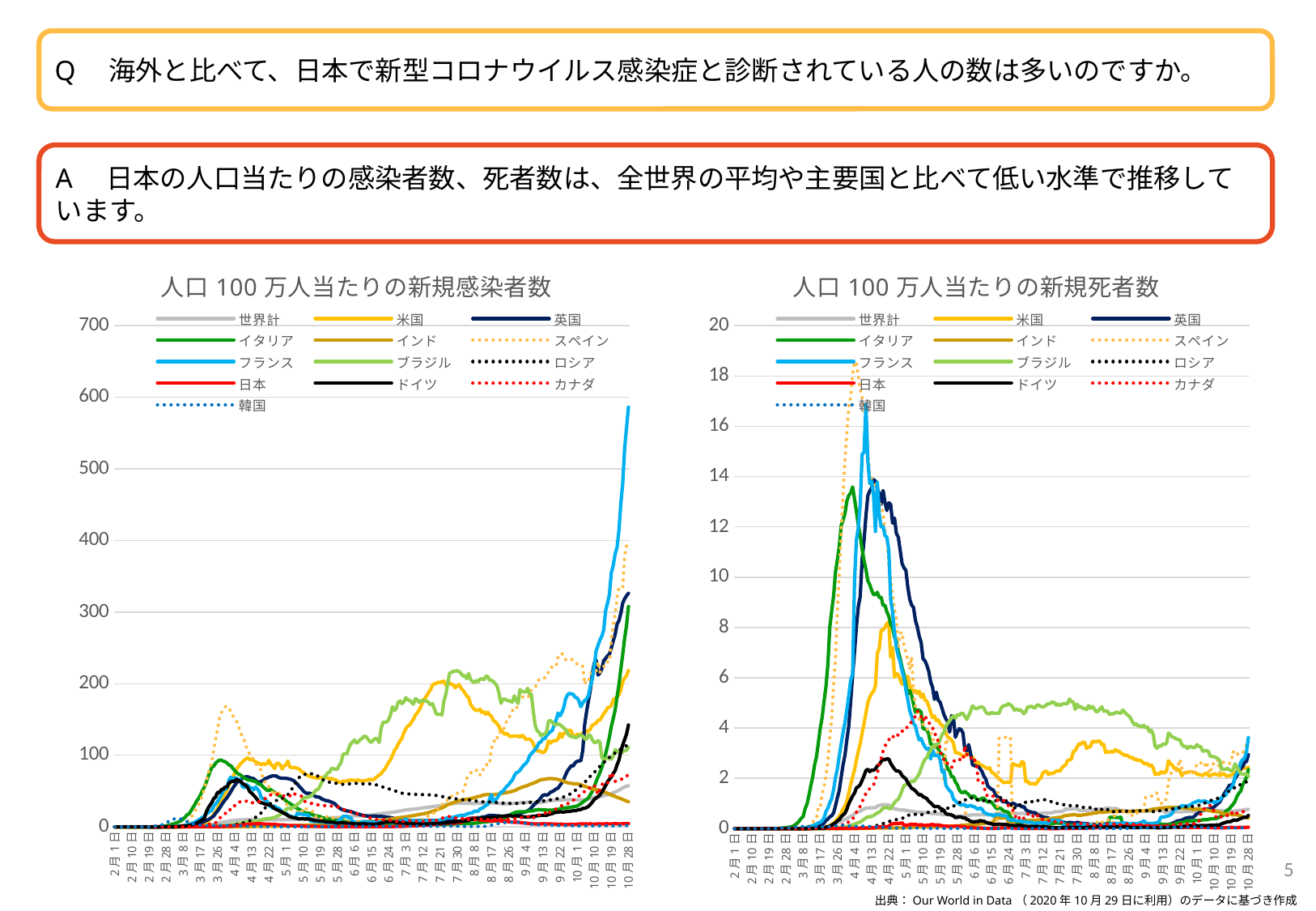
In the right chart (人口100万人当たりの新規死者数), is the peak value for スペイン greater or less than 16? greater In the left chart (人口100万人当たりの新規感染者数), is the value for フランス at 10月28日 greater or less than 500? greater In the right chart (人口100万人当たりの新規死者数), which has the higher peak, イタリア or ドイツ? イタリア In the right chart (人口100万人当たりの新規死者数), is the value for 日本 at any point greater or less than 2? less In the left chart (人口100万人当たりの新規感染者数), does the value for フランス rise or fall from 9月 to 10月28日? rise What kind of chart is the left chart titled 人口100万人当たりの新規感染者数? line chart In the left chart (人口100万人当たりの新規感染者数), which series is drawn as a dotted orange line? スペイン How many series does the legend of the right chart (人口100万人当たりの新規死者数) list? 13 In the left chart (人口100万人当たりの新規感染者数), which series has the highest value at 10月28日? フランス In the right chart (人口100万人当たりの新規死者数), which series reaches the highest peak? スペイン What is the title of the right chart? 人口100万人当たりの新規死者数